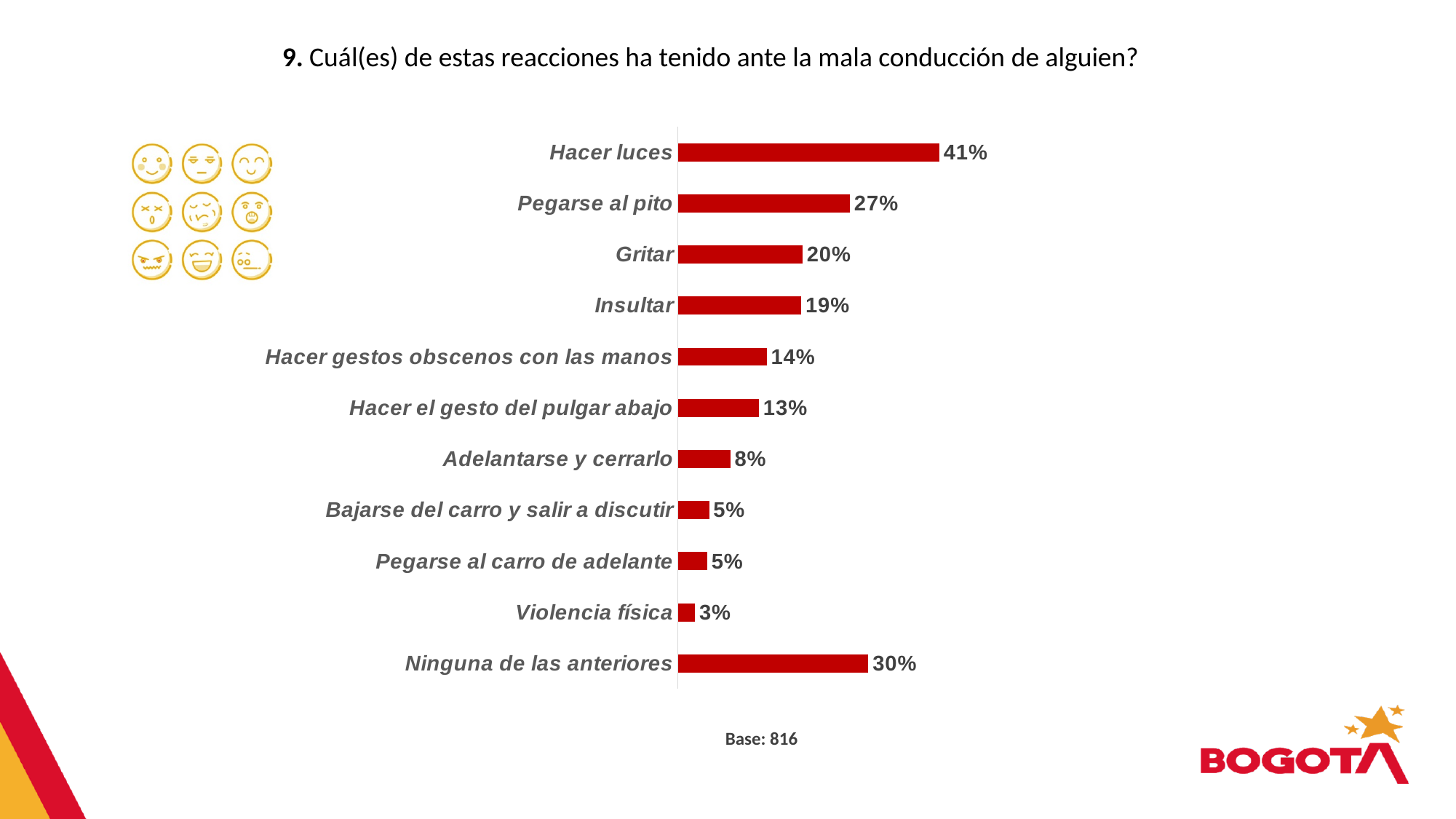
Which category has the highest value? Hacer luces What is the value for "Pegarse al pito"? 27% Which is larger, the value for "Gritar" or the value for "Insultar"? Gritar What is the value for "Ninguna de las anteriores"? 30% What is the value for "Hacer luces"? 41% What is the value for "Violencia física"? 3% What is the difference between the values for "Ninguna de las anteriores" and "Gritar"? 10% How many categories are shown in the chart? 11 What kind of chart is shown on the slide? Bar chart Which category has the lowest value? Violencia física What base (number of respondents) is stated below the chart? 816 What is the difference between the values for "Hacer luces" and "Pegarse al pito"? 14%